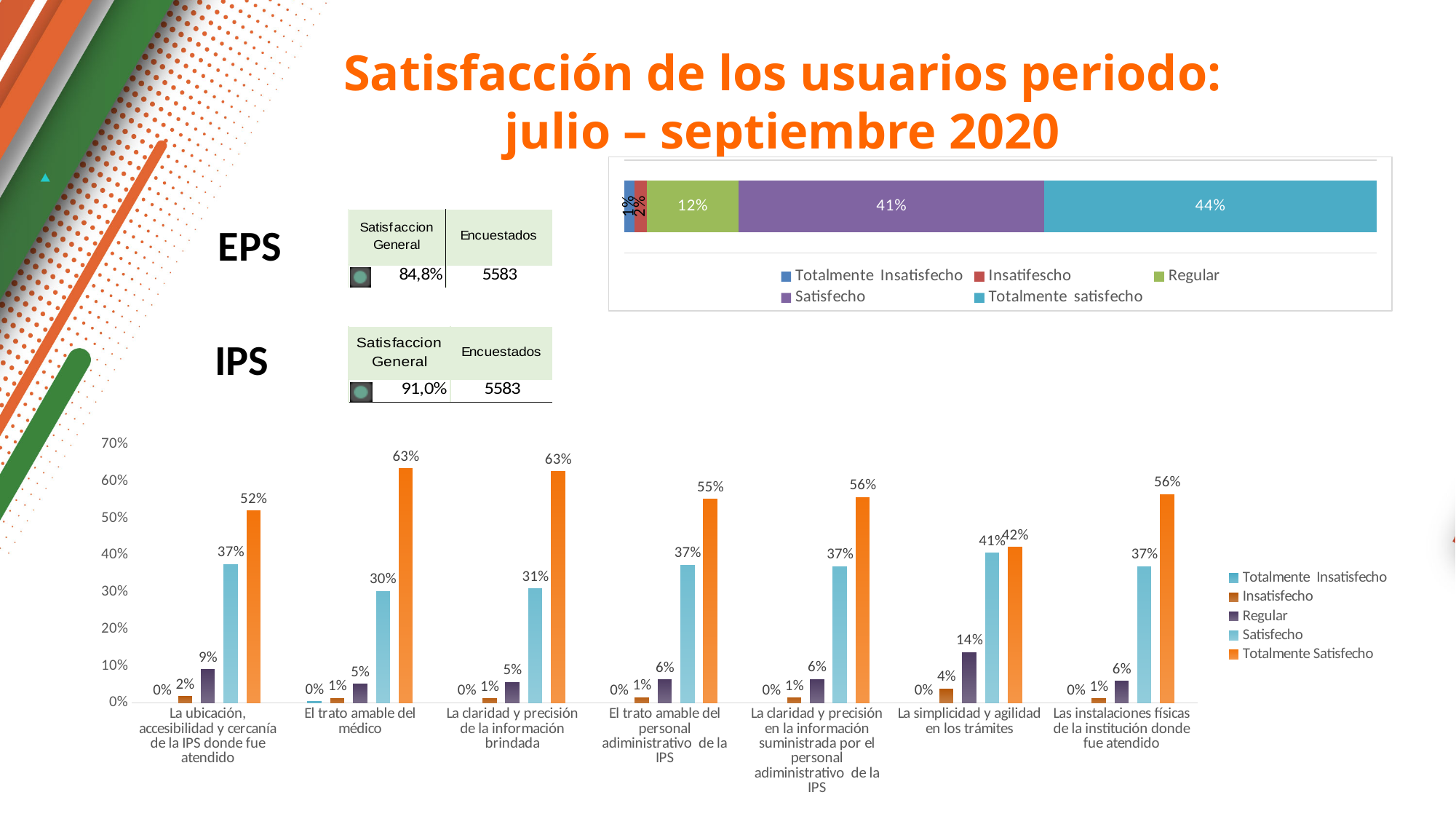
In the bottom bar chart, what is the Regular value for 'La simplicidad y agilidad en los trámites'? 14% In the stacked bar chart at the top right, what percentage is shown for the Totalmente satisfecho segment? 44% In the stacked bar chart at the top right, what is the difference between the Totalmente satisfecho and Satisfecho segments? 3% In the stacked bar chart at the top right, what percentage is shown for the Regular segment? 12% In the stacked bar chart at the top right, which segment is the largest? Totalmente satisfecho In the bottom bar chart, is the Totalmente Satisfecho value for 'La simplicidad y agilidad en los trámites' larger or smaller than its Satisfecho value? larger In the bottom bar chart, how many categories are shown on the x axis? 7 In the bottom bar chart, what is the difference between the Totalmente Satisfecho and Satisfecho values for 'La ubicación, accesibilidad y cercanía de la IPS donde fue atendido'? 15% What type of chart is the bottom chart? bar chart In the bottom bar chart, what is the Totalmente Satisfecho value for 'El trato amable del médico'? 63% In the bottom bar chart, which category has the highest Regular value? La simplicidad y agilidad en los trámites In the stacked bar chart at the top right, how many series does the legend list? 5